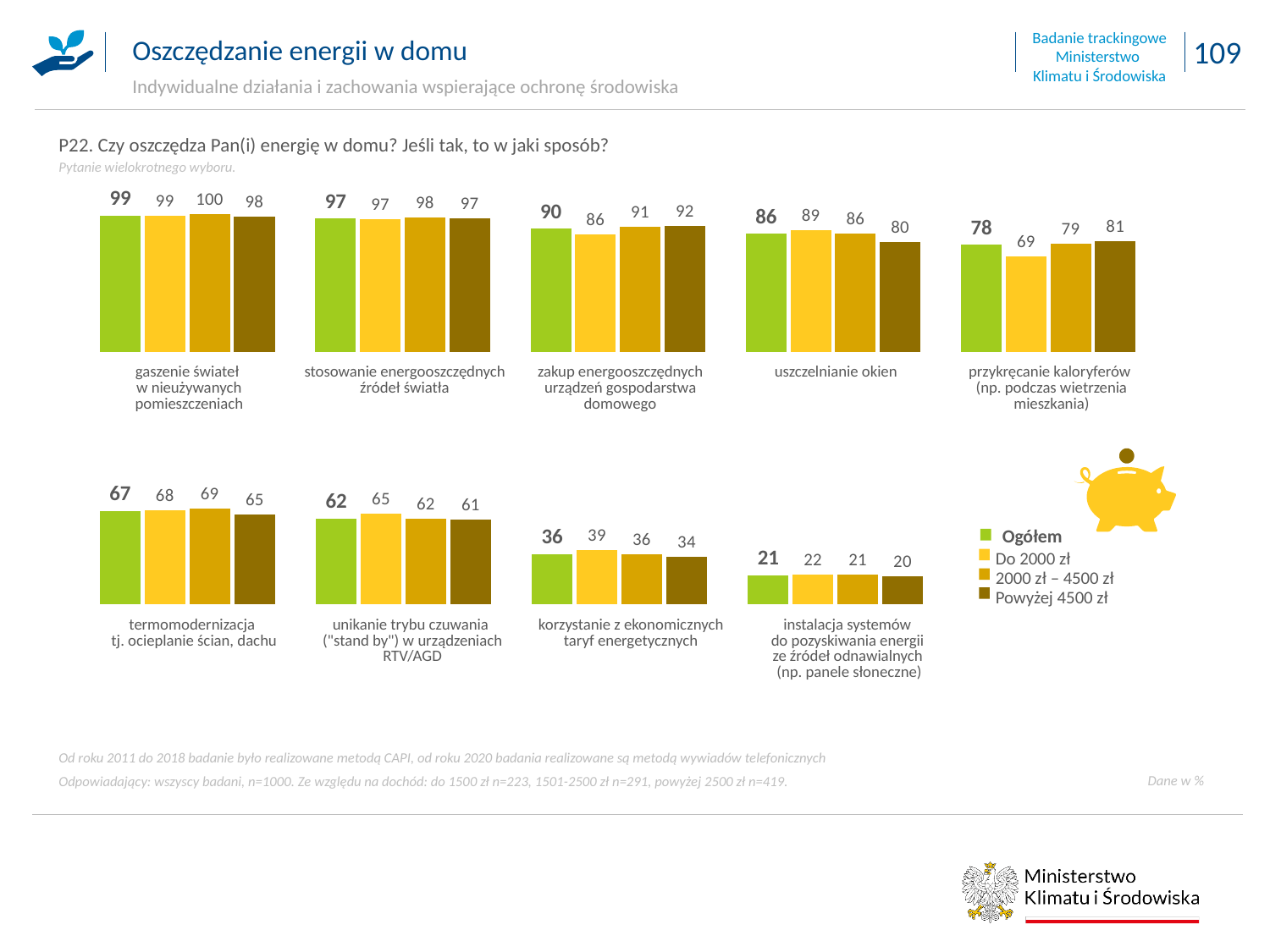
How many series does the legend list? 4 What kind of chart is used for 'unikanie trybu czuwania ("stand by") w urządzeniach RTV/AGD'? Bar chart In the chart for 'przykręcanie kaloryferów', which income group has the highest value? Powyżej 4500 zł In the chart for 'przykręcanie kaloryferów', what is the difference between the 'Powyżej 4500 zł' value and the 'Do 2000 zł' value? 12 How many bars are shown in the chart for 'termomodernizacja tj. ocieplanie ścian, dachu'? 4 Which legend entry is shown in bold? Ogółem In the chart for 'uszczelnianie okien', what is the value for the 'Powyżej 4500 zł' group? 80 In the chart for 'gaszenie świateł w nieużywanych pomieszczeniach', what is the value for Ogółem? 99 In the chart for 'korzystanie z ekonomicznych taryf energetycznych', which is larger: the value for 'Do 2000 zł' or for 'Powyżej 4500 zł'? Do 2000 zł In the chart for 'uszczelnianie okien', which income group has the lowest value? Powyżej 4500 zł In the chart for 'instalacja systemów do pozyskiwania energii ze źródeł odnawialnych', what is the value for the '2000 zł – 4500 zł' group? 21 In the chart for 'przykręcanie kaloryferów', what is the value for the 'Do 2000 zł' group? 69